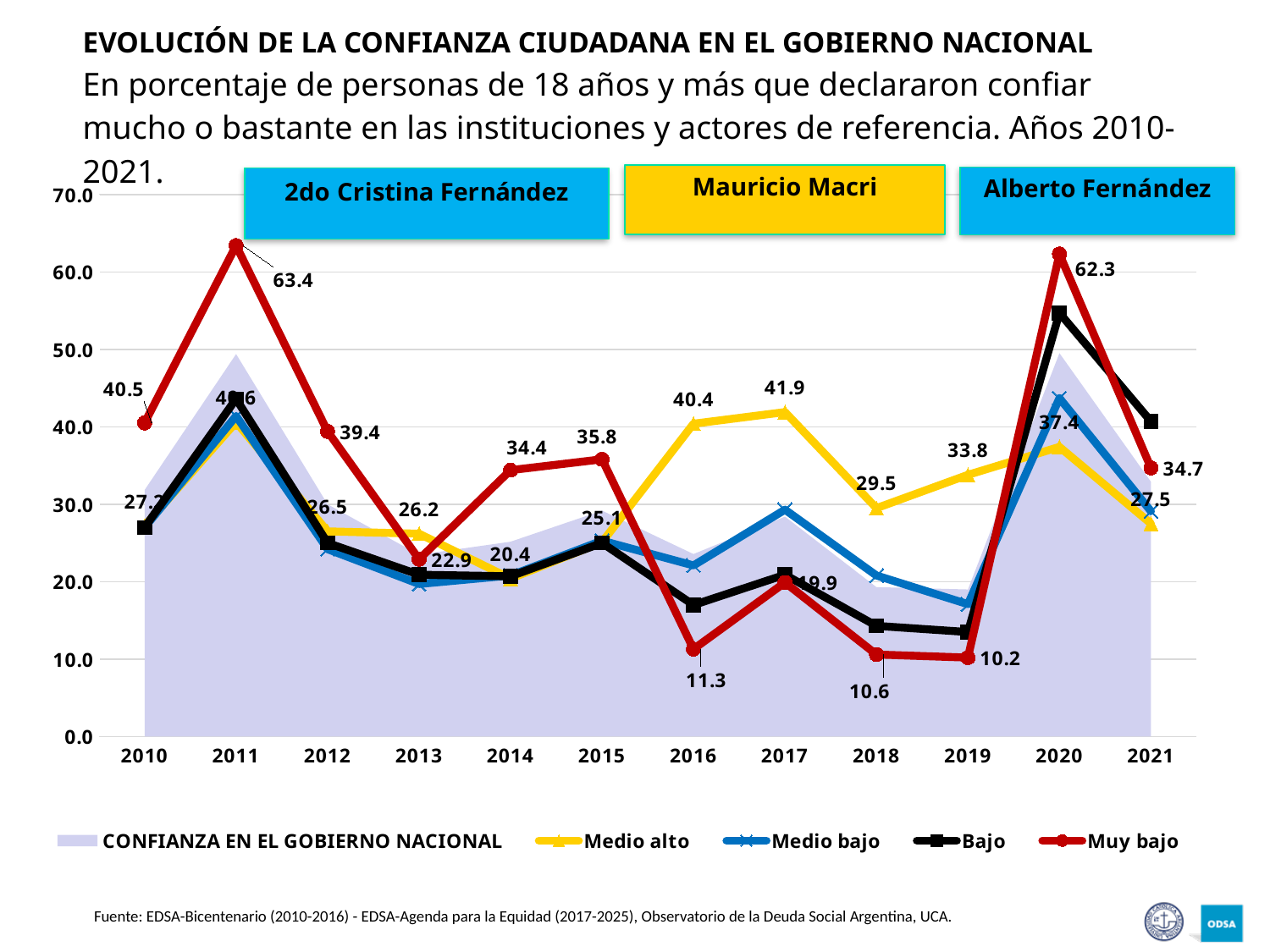
In 2016, which is larger: the Medio alto value or the Muy bajo value? Medio alto What kind of chart is shown on the slide? combination area and line chart How many series does the legend list? 5 What is the value of the Muy bajo series in 2020? 62.3 What is the difference between the Muy bajo values in 2011 and 2020? 1.1 In which year does the Muy bajo series reach its lowest value? 2019 What is the value of the Muy bajo series in 2019? 10.2 What is the value of the Muy bajo series in 2011? 63.4 Is the value of the Bajo series in 2020 greater or less than 50? greater How many years are shown on the x axis? 12 In which year does the Muy bajo series reach its highest value? 2011 What is the value of the Medio alto series in 2017? 41.9